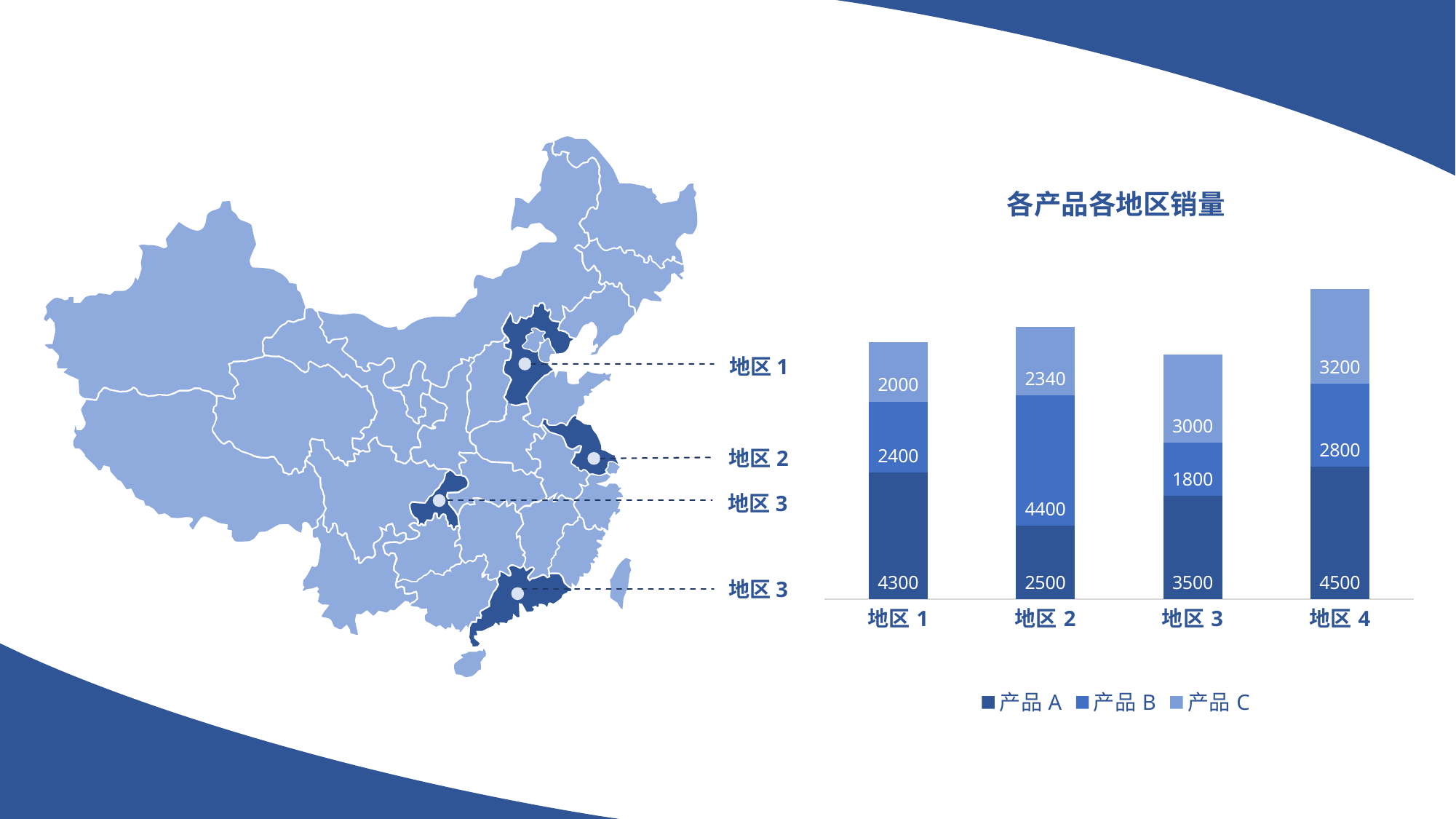
What is the total of the stacked bar for 地区 4? 10500 What is the title of the chart? 各产品各地区销量 Which region has the lowest value for 产品 B? 地区 3 What is the difference between 产品 A for 地区 4 and 产品 A for 地区 2? 2000 What is the value of 产品 B for 地区 2? 4400 What is the value of 产品 C for 地区 3? 3000 How many series does the chart legend list? 3 Which is larger: 产品 C for 地区 4 or 产品 C for 地区 1? 产品 C for 地区 4 Which region has the highest value for 产品 A? 地区 4 How many regions (categories) are shown on the x axis of the chart? 4 What is the value of 产品 A for 地区 1? 4300 What type of chart is shown on the slide? Stacked bar chart